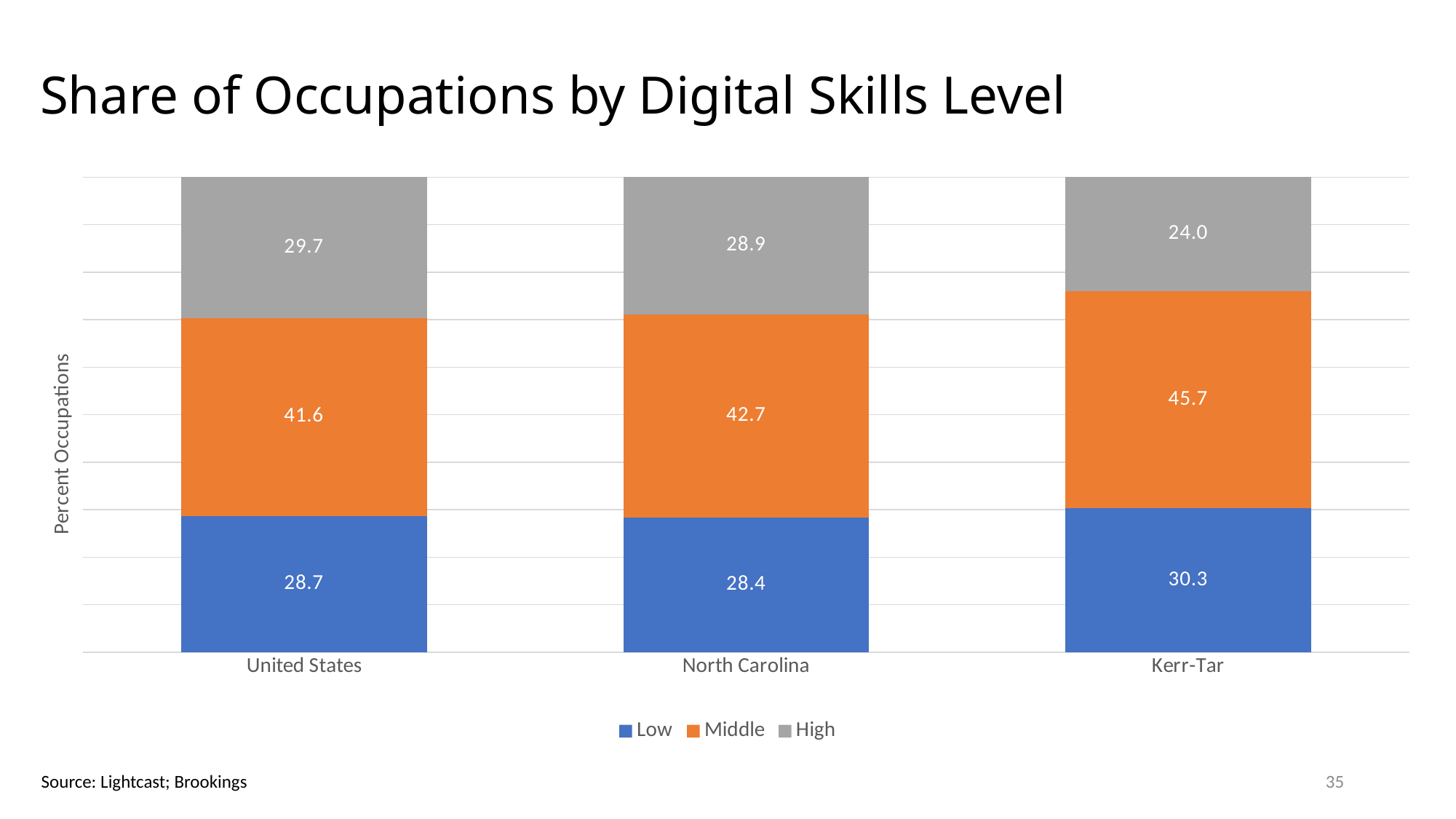
What is the label on the vertical axis? Percent Occupations What is the difference between the Middle values for Kerr-Tar and United States? 4.1 What is the Low value for North Carolina? 28.4 What is the Middle value for Kerr-Tar? 45.7 What is the High value for United States? 29.7 Which category has the lowest High value? Kerr-Tar What is the total of the stacked bar for North Carolina? 100.0 How many series does the legend list? 3 Which is larger, the High value for United States or the High value for Kerr-Tar? United States Which category has the highest Middle value? Kerr-Tar What kind of chart is shown on the slide? Stacked bar chart How many categories are shown on the x axis? 3